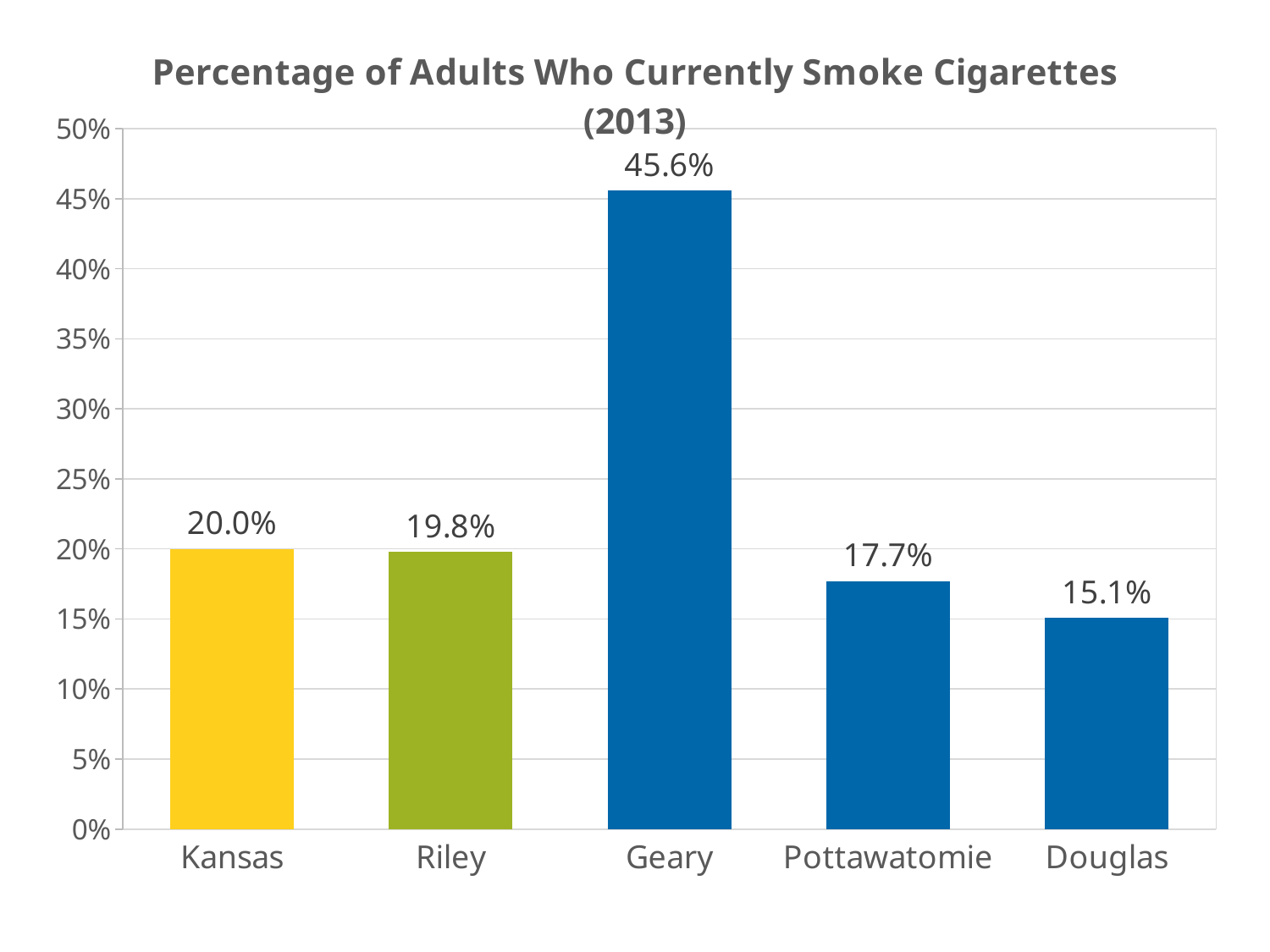
What is the difference between the values for Riley and Douglas? 4.7% What is the value shown for Douglas? 15.1% What is the value shown for Kansas? 20.0% How many categories are shown on the x axis? 5 What kind of chart is shown on the slide? Bar chart Which category has the lowest percentage of adults who currently smoke? Douglas What is the difference between the values for Geary and Kansas? 25.6% Which has a higher value, Pottawatomie or Douglas? Pottawatomie What is the percentage of adults who currently smoke cigarettes in Geary? 45.6% What is the value shown for Pottawatomie? 17.7% Is the value for Geary greater or less than 40%? greater Which category has the highest percentage of adults who currently smoke? Geary